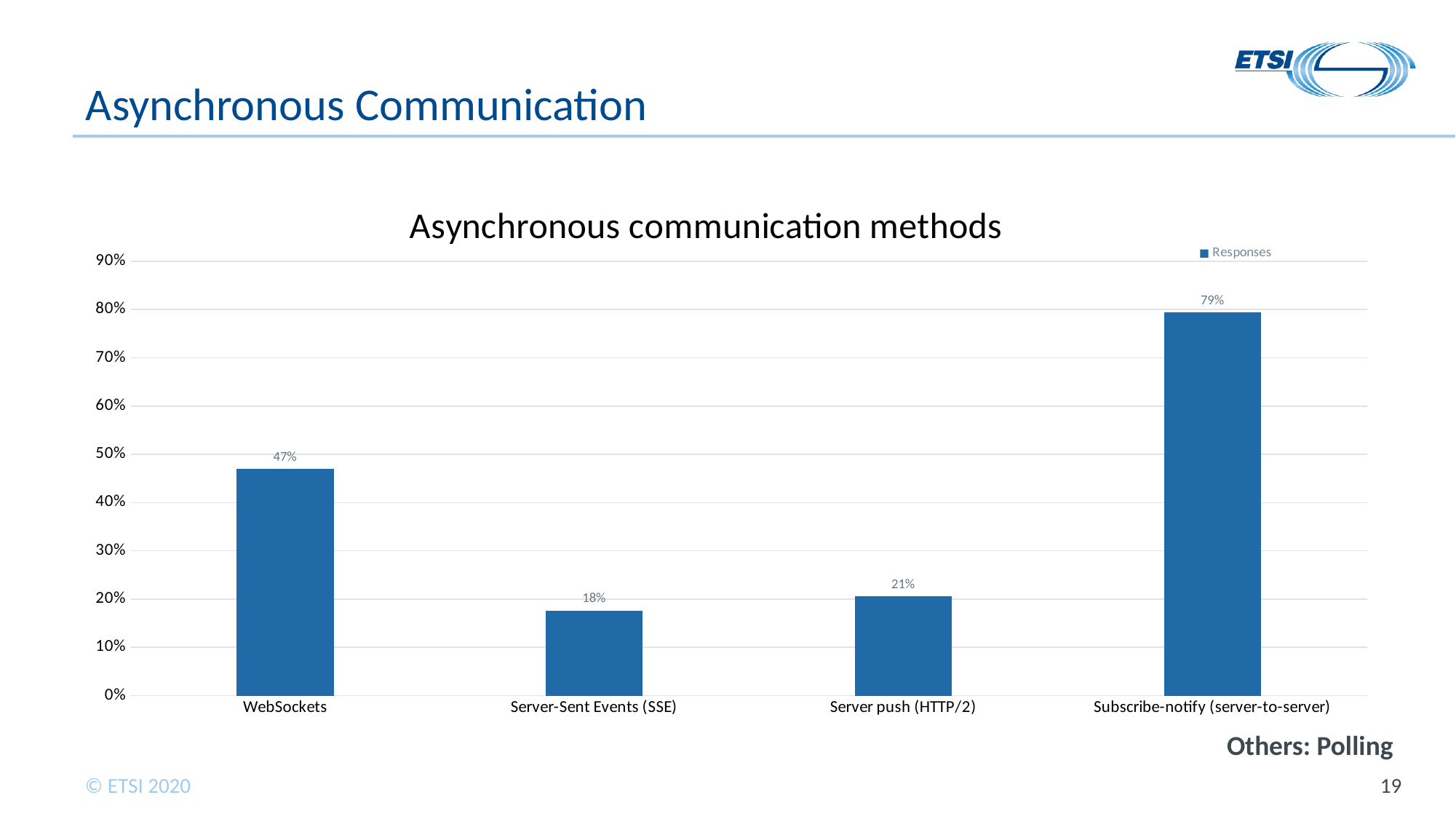
Which is larger, the value for WebSockets or the value for Server push (HTTP/2)? WebSockets What is the value for WebSockets? 47% What is the title of the chart? Asynchronous communication methods Which category has the highest value? Subscribe-notify (server-to-server) How many categories are shown on the x axis? 4 What is the value for Subscribe-notify (server-to-server)? 79% Is the value for WebSockets greater or less than 40%? greater What is the difference between the values for Subscribe-notify (server-to-server) and WebSockets? 32% What is the value for Server-Sent Events (SSE)? 18% Which category has the lowest value? Server-Sent Events (SSE) What kind of chart is shown on the slide? bar chart What is the value for Server push (HTTP/2)? 21%